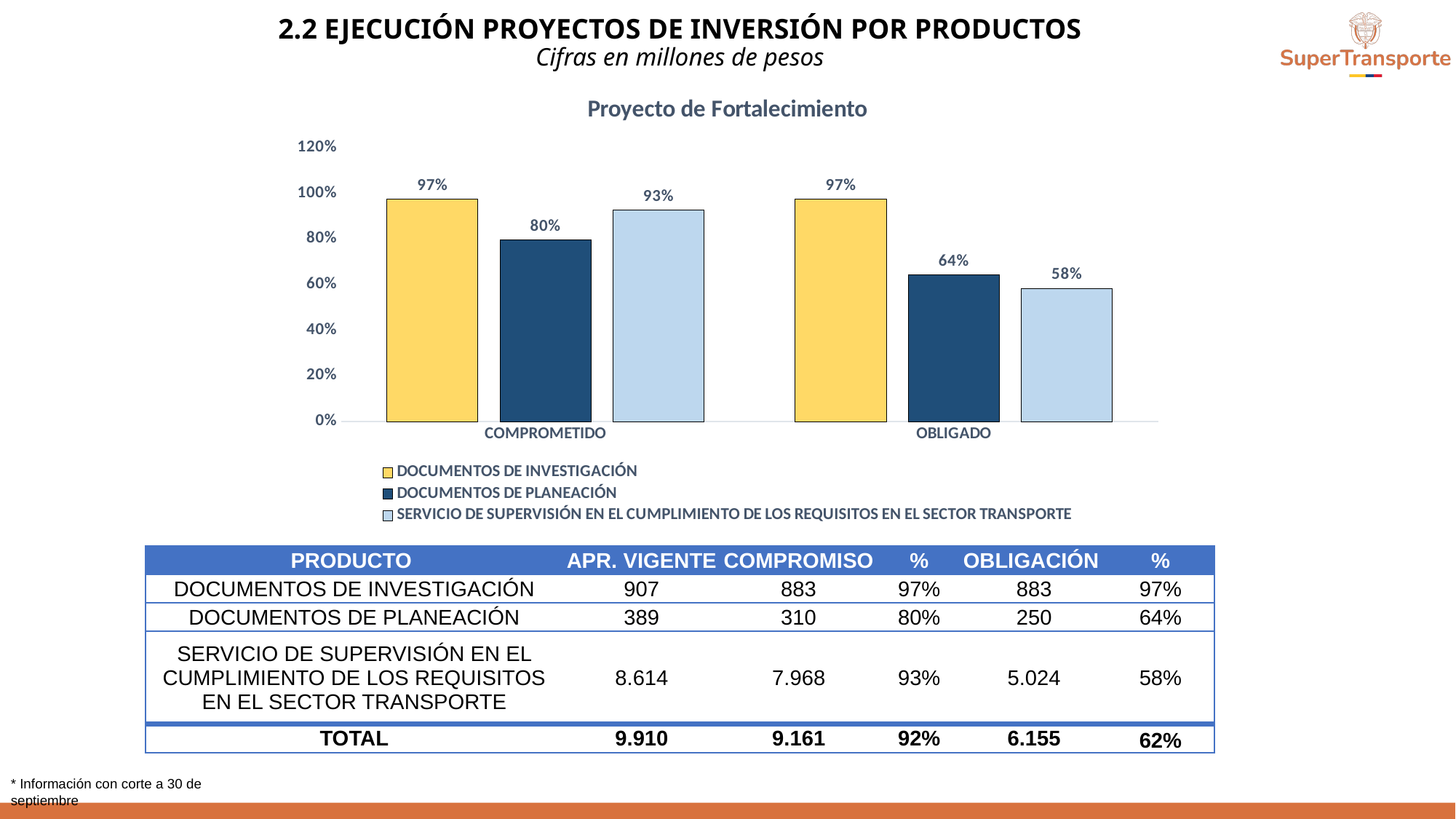
What kind of chart is shown? Bar chart How many categories are shown on the x axis? 2 How many series does the legend list? 3 Which series has the lowest value in the COMPROMETIDO group? DOCUMENTOS DE PLANEACIÓN Which is larger: the COMPROMETIDO value for DOCUMENTOS DE PLANEACIÓN or the COMPROMETIDO value for SERVICIO DE SUPERVISIÓN EN EL CUMPLIMIENTO DE LOS REQUISITOS EN EL SECTOR TRANSPORTE? SERVICIO DE SUPERVISIÓN EN EL CUMPLIMIENTO DE LOS REQUISITOS EN EL SECTOR TRANSPORTE What is the value for DOCUMENTOS DE INVESTIGACIÓN in the OBLIGADO group? 97% What is the value for SERVICIO DE SUPERVISIÓN EN EL CUMPLIMIENTO DE LOS REQUISITOS EN EL SECTOR TRANSPORTE in the OBLIGADO group? 58% Which series has the lowest value in the OBLIGADO group? SERVICIO DE SUPERVISIÓN EN EL CUMPLIMIENTO DE LOS REQUISITOS EN EL SECTOR TRANSPORTE What is the difference between the COMPROMETIDO and OBLIGADO values for SERVICIO DE SUPERVISIÓN EN EL CUMPLIMIENTO DE LOS REQUISITOS EN EL SECTOR TRANSPORTE? 35% What is the difference between the COMPROMETIDO and OBLIGADO values for DOCUMENTOS DE PLANEACIÓN? 16% What is the title of the chart? Proyecto de Fortalecimiento What is the value for DOCUMENTOS DE PLANEACIÓN in the COMPROMETIDO group? 80%